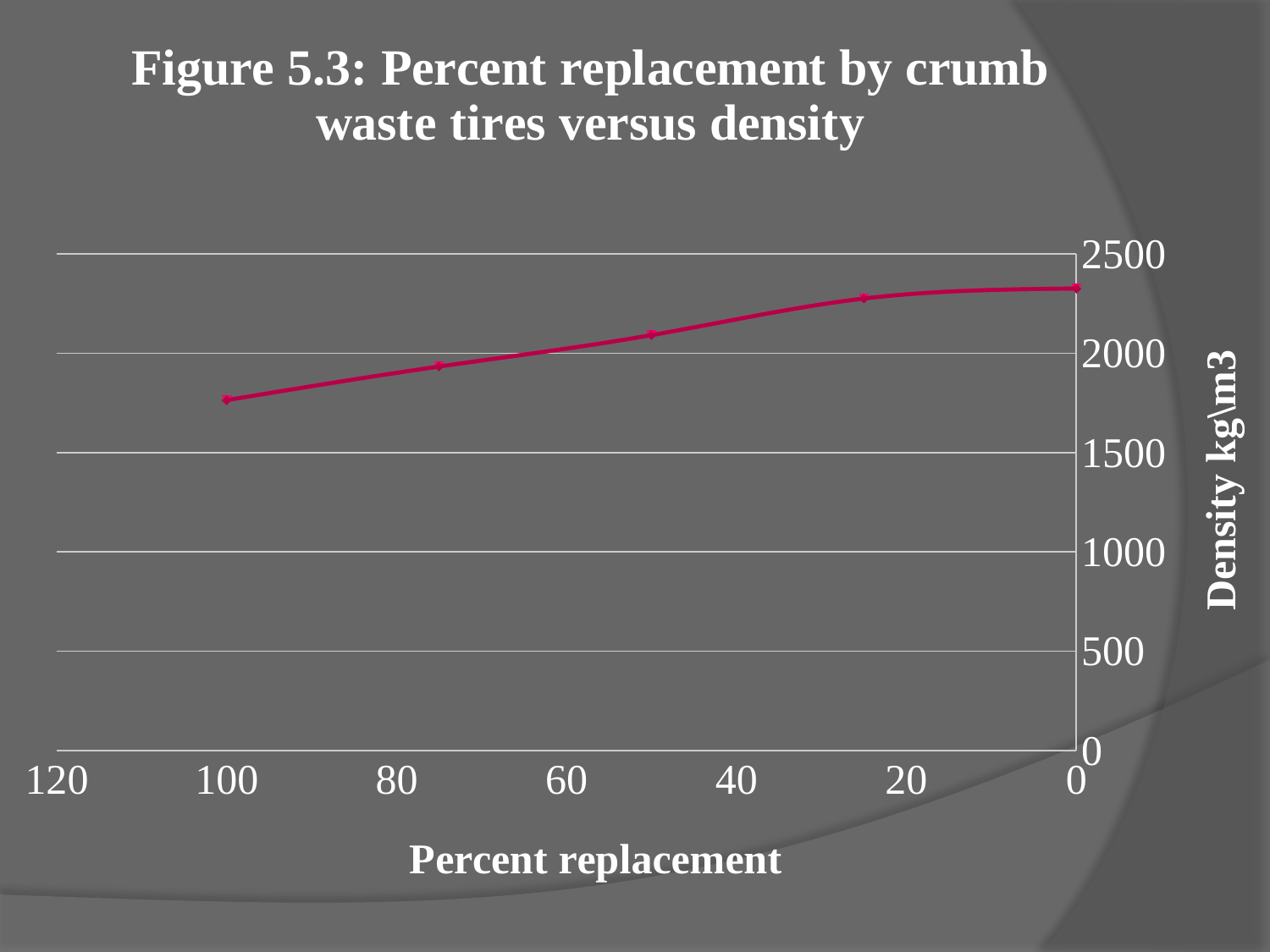
Is the density at 100 percent replacement greater or less than 2000? less What kind of chart is shown on the slide? line chart Is the density at 0 percent replacement greater or less than 2000? greater Is the density at 25 percent replacement greater or less than 2000? greater At which percent replacement is the density highest? 0 Which has the higher density: 0 percent replacement or 100 percent replacement? 0 percent replacement How many data points are plotted on the line? 5 What is the label of the y axis? Density kg\m3 What is the label of the x axis? Percent replacement At which percent replacement is the density lowest? 100 Moving from left to right along the x axis, does the line rise or fall? rise